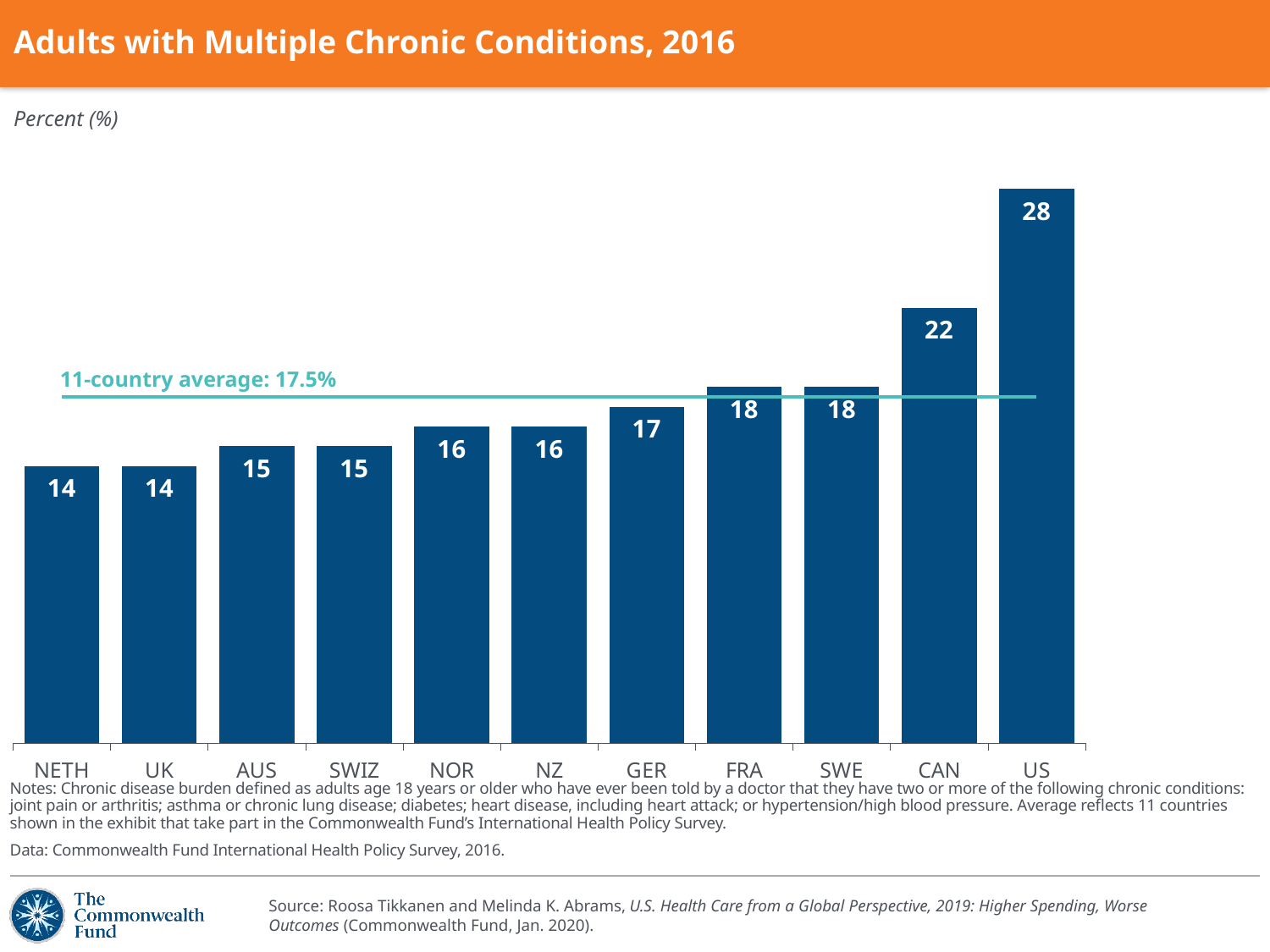
What is the difference between the values for the US and CAN? 6 What kind of chart is this? bar chart What is the value for the US? 28 What is the title of the chart? Adults with Multiple Chronic Conditions, 2016 How many countries are shown in the chart? 11 What is the value for GER? 17 Which is larger, the value for NOR or the value for SWE? SWE Which country has the highest value? US What is the value for CAN? 22 Do the values rise or fall from left to right across the countries? rise What is the difference between the values for FRA and NETH? 4 What is the 11-country average shown on the chart? 17.5%